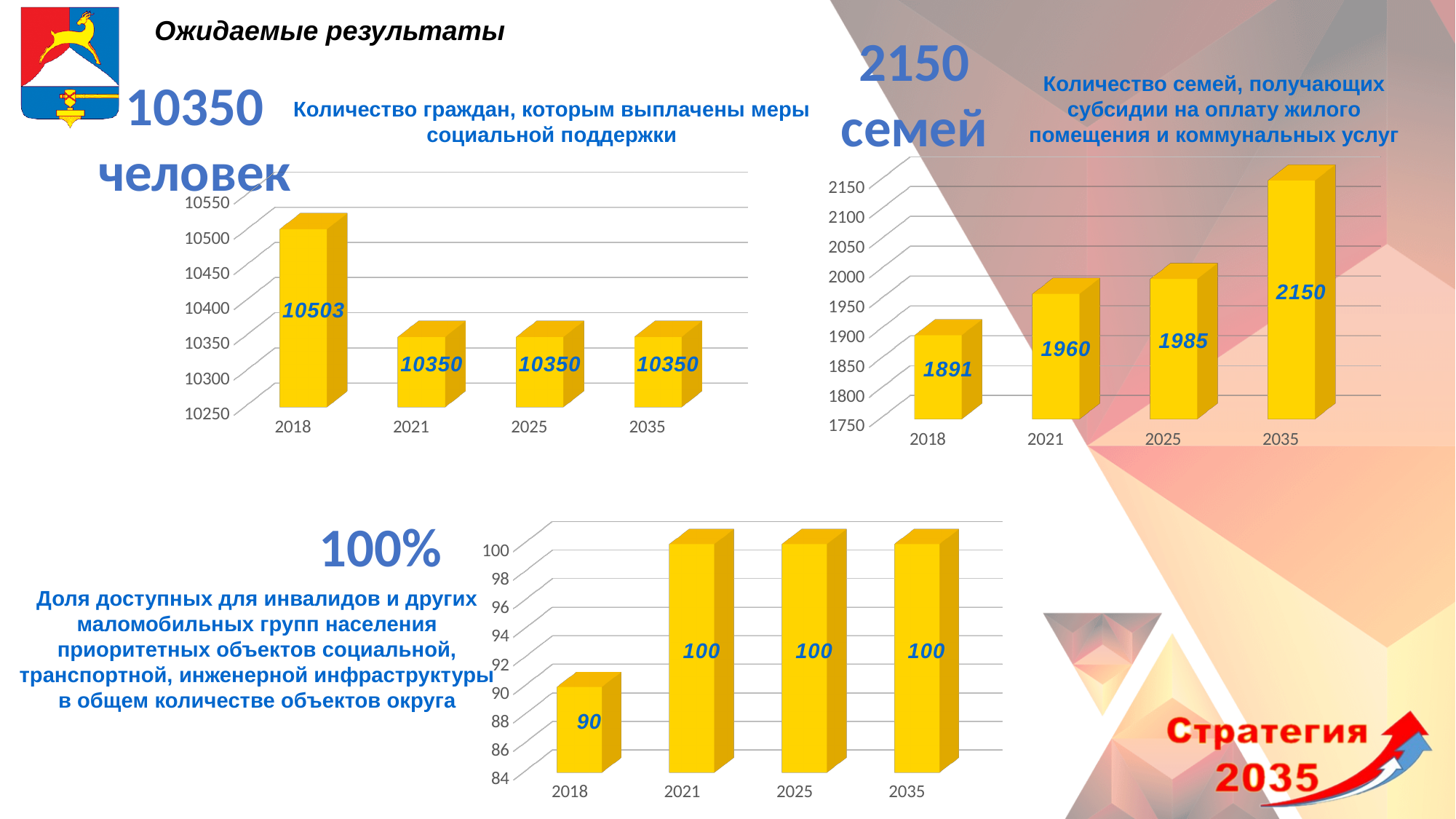
In the top-right chart (Количество семей, получающих субсидии на оплату жилого помещения и коммунальных услуг), which year has the lowest value? 2018 In the top-left chart (Количество граждан, которым выплачены меры социальной поддержки), what is the value for 2018? 10503 What kind of chart is the bottom chart (Доля доступных для инвалидов и других маломобильных групп населения приоритетных объектов)? bar chart In the top-left chart (Количество граждан, которым выплачены меры социальной поддержки), how many years are shown on the x axis? 4 In the top-left chart (Количество граждан, которым выплачены меры социальной поддержки), what is the difference between the 2018 value and the 2021 value? 153 In the bottom chart (Доля доступных для инвалидов и других маломобильных групп населения приоритетных объектов), which is larger, the value for 2018 or the value for 2021? 2021 In the bottom chart (Доля доступных для инвалидов и других маломобильных групп населения приоритетных объектов), what is the value for 2018? 90 In the top-right chart (Количество семей, получающих субсидии на оплату жилого помещения и коммунальных услуг), what is the value for 2021? 1960 In the top-right chart (Количество семей, получающих субсидии на оплату жилого помещения и коммунальных услуг), what is the difference between the 2035 value and the 2018 value? 259 In the top-left chart (Количество граждан, которым выплачены меры социальной поддержки), which year has the highest value? 2018 How many charts are shown on the slide? 3 In the top-right chart (Количество семей, получающих субсидии на оплату жилого помещения и коммунальных услуг), do the values rise or fall from 2018 to 2035? rise